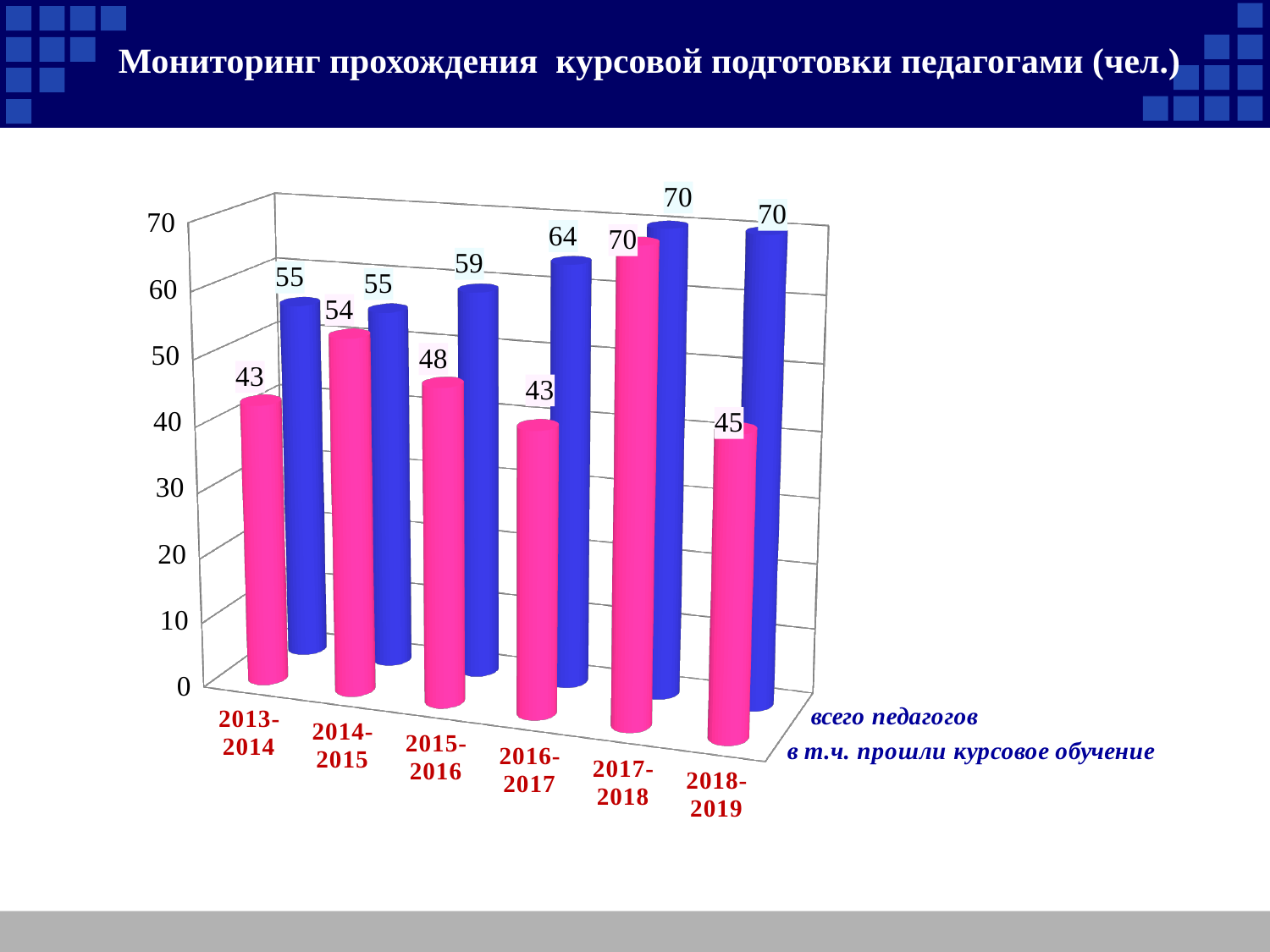
What kind of chart is shown on the slide? bar chart What is the value of the pink bar for 2017-2018? 70 How many series does the legend list? 2 What is the difference between the pink bars for 2014-2015 and 2015-2016? 6 How many academic-year categories are shown on the x axis? 6 In which year is the pink bar highest? 2017-2018 Do the blue bars rise or fall from 2013-2014 to 2018-2019? rise What is the value of the blue bar for 2015-2016? 59 What is the value of the blue bar for 2016-2017? 64 Which is larger: the pink bar for 2014-2015 or the pink bar for 2015-2016? 2014-2015 What is the value of the pink bar for 2013-2014? 43 What is the difference between the blue bar and the pink bar for 2018-2019? 25